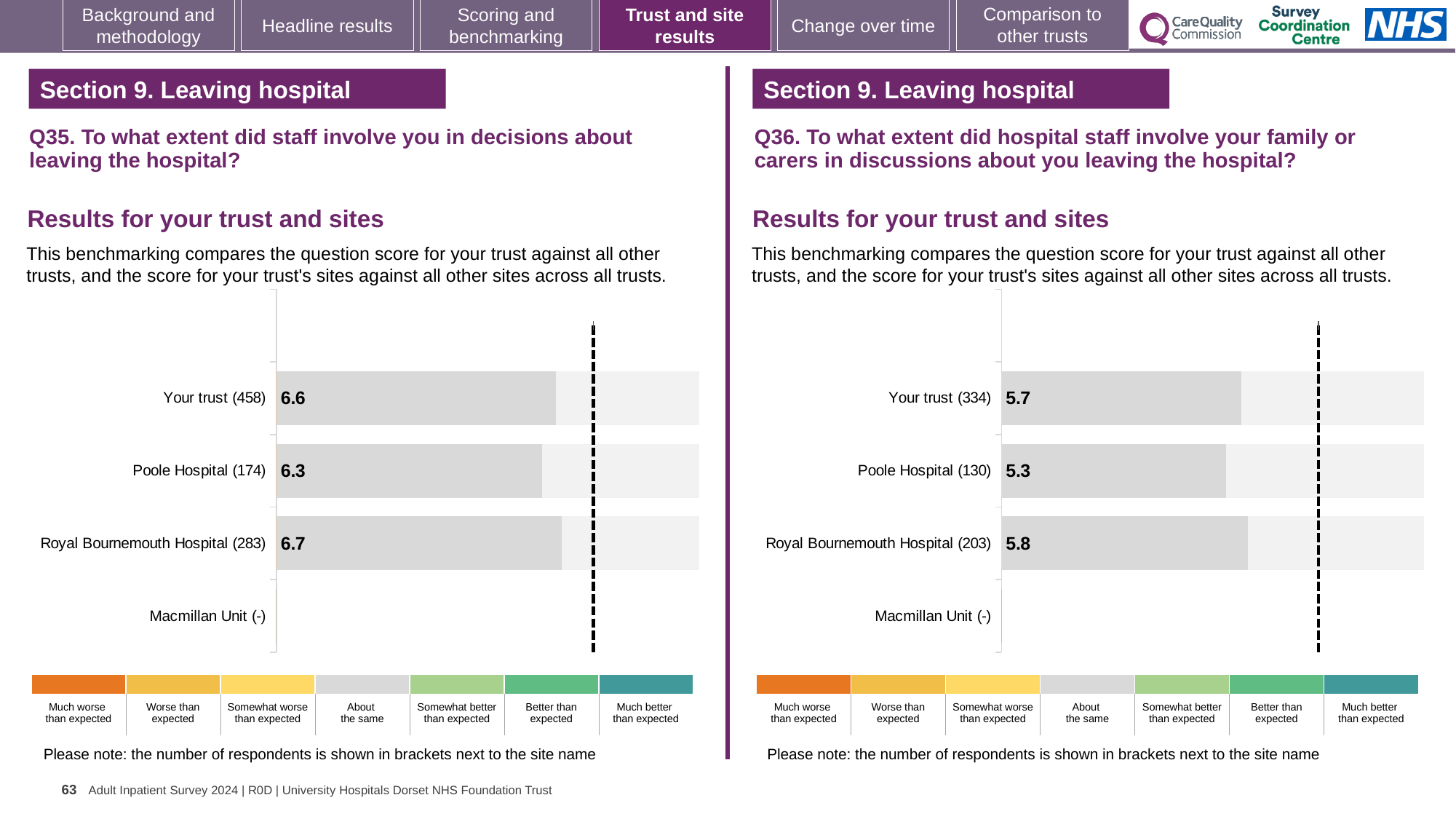
In the Q36 chart on the right, what is the score for Your trust? 5.7 In the Q36 chart on the right, what is the difference between the scores for Your trust and Poole Hospital? 0.4 What kind of chart is used in the Q35 chart on the left? Bar chart In the Q36 chart on the right, what is the score for Royal Bournemouth Hospital? 5.8 In the Q36 chart on the right, which site has the lowest score? Poole Hospital In the Q35 chart on the left, which site has the highest score? Royal Bournemouth Hospital In the Q35 chart on the left, what is the score for Poole Hospital? 6.3 In the Q35 chart on the left, what is the difference between the scores for Royal Bournemouth Hospital and Poole Hospital? 0.4 In the Q36 chart on the right, which is larger: the score for Royal Bournemouth Hospital or Poole Hospital? Royal Bournemouth Hospital How many respondents are shown in brackets for Your trust in the Q35 chart on the left? 458 How many site rows are listed in the Q36 chart on the right? 4 In the Q35 chart on the left, what is the score for Your trust? 6.6